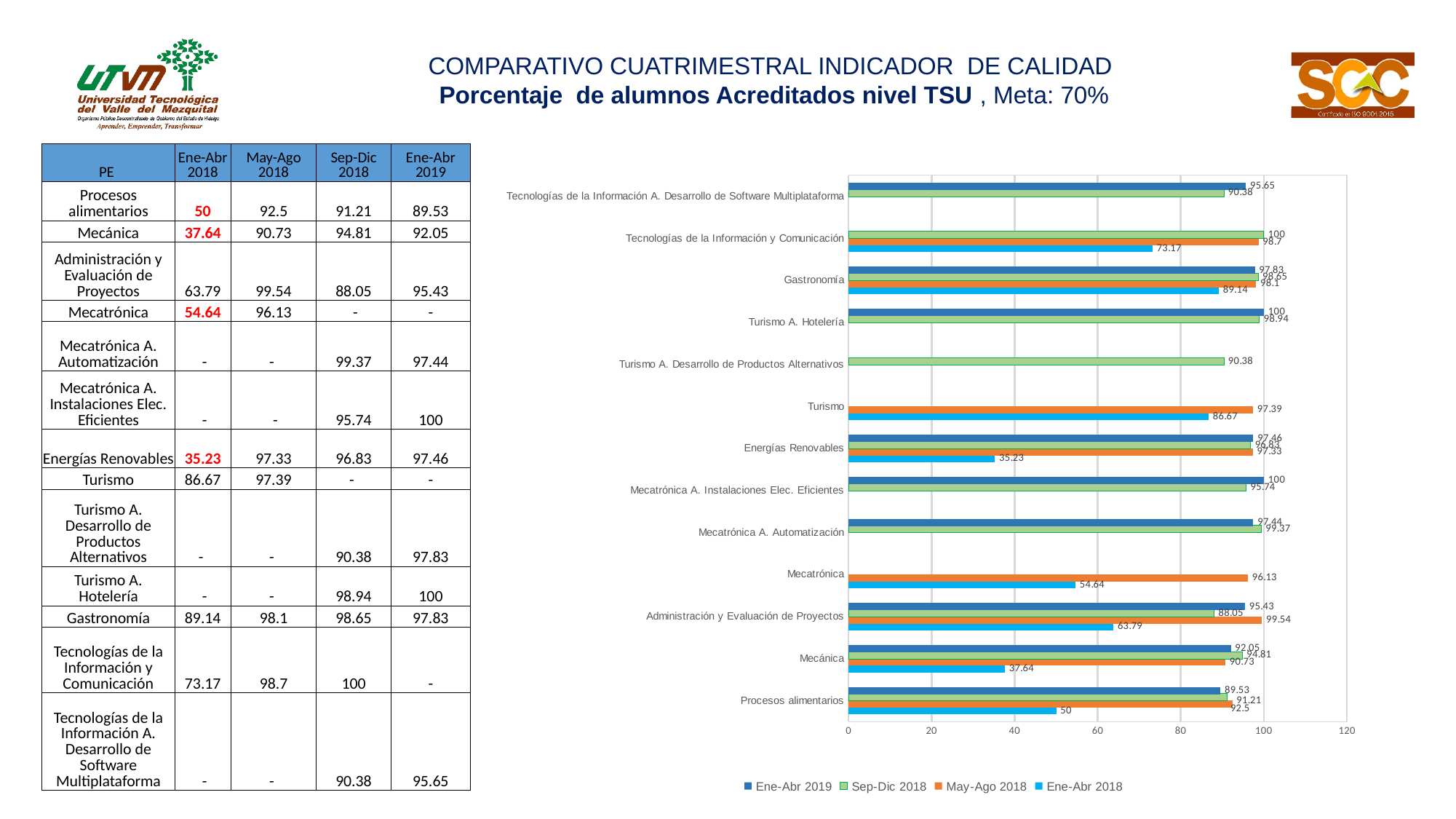
Which program has the lowest Ene-Abr 2018 value on the chart? Energías Renovables How many series does the chart legend list? 4 What is the Ene-Abr 2018 value for Energías Renovables on the chart? 35.23 How many programs (categories) are plotted on the chart? 13 What is the Sep-Dic 2018 value for Turismo A. Desarrollo de Productos Alternativos? 90.38 For Procesos alimentarios, which is larger: the Ene-Abr 2019 value or the Sep-Dic 2018 value? Sep-Dic 2018 Is the Ene-Abr 2018 value for Mecatrónica greater or less than 60? less What kind of chart is shown on the slide? Bar chart What is the Ene-Abr 2019 value for Turismo A. Hotelería? 100 What is the May-Ago 2018 value for Mecánica on the chart? 90.73 What is the difference between the May-Ago 2018 and Ene-Abr 2018 values for Administración y Evaluación de Proyectos? 35.75 What is the difference between the May-Ago 2018 and Ene-Abr 2018 values for Mecánica? 53.09